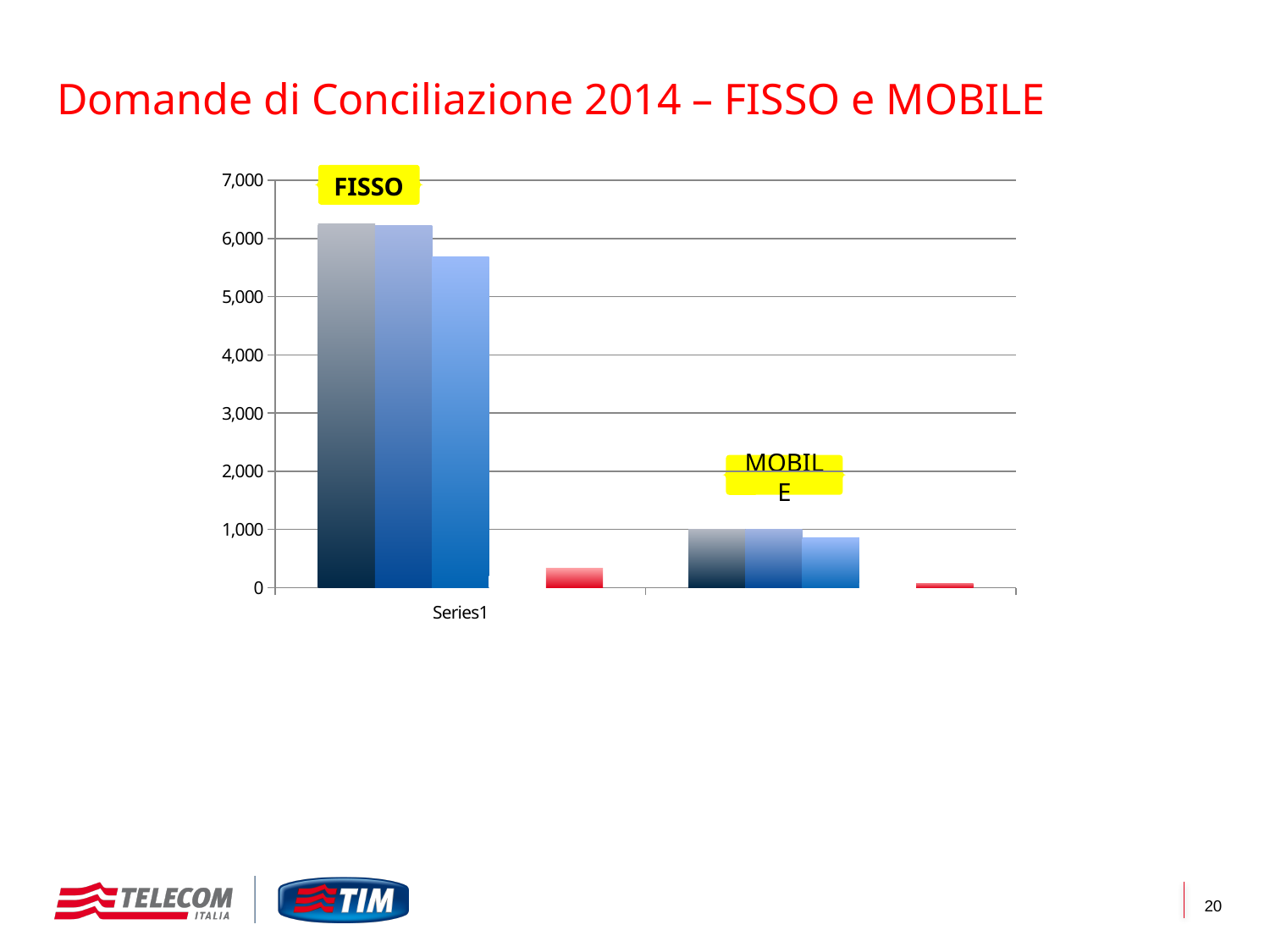
What label appears under the x axis of the chart? Series1 Which bar is taller: the red bar in the FISSO group or the red bar in the MOBILE group? the red bar in the FISSO group Which group has the taller bars, FISSO or MOBILE? FISSO What kind of chart is shown on the slide? bar chart Is the value of the red bar in the FISSO group greater or less than 1,000? less What are the two highlighted group labels on the chart? FISSO and MOBILE Is the value of the third (light blue) MOBILE bar greater or less than 1,000? less How many labelled groups of bars does the chart show? 2 Is the value of the tallest MOBILE bar greater or less than 2,000? less